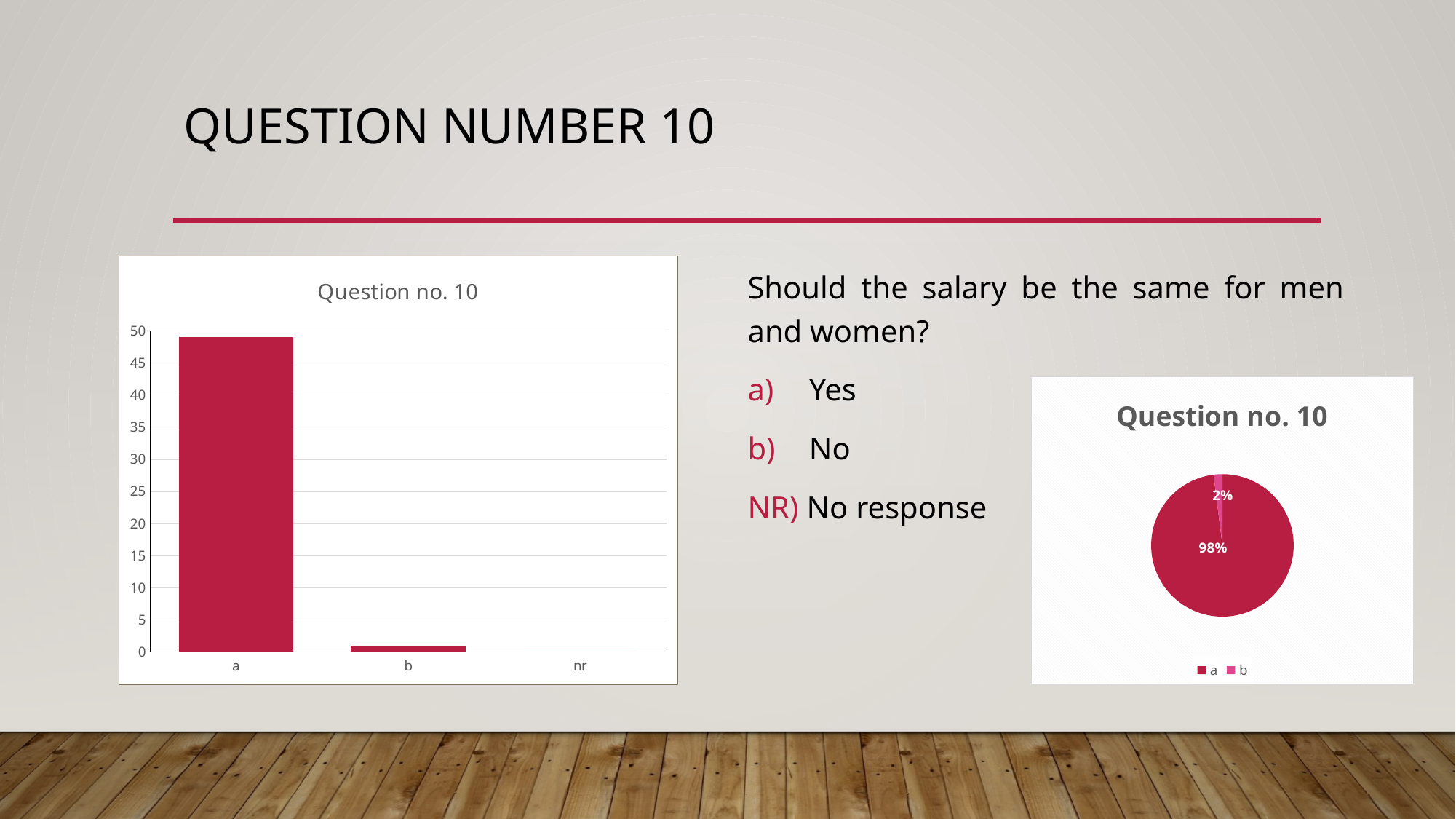
In the bar chart on the left, how many categories are shown on the x axis? 3 In the pie chart on the right, which slice is the largest? a In the bar chart on the left, is the value for b greater or less than 5? less In the bar chart on the left, which category has the highest value? a In the bar chart on the left, which is larger, the value for a or the value for b? a What kind of chart is the chart on the right of the slide? pie chart What is the title of the pie chart on the right? Question no. 10 In the pie chart on the right, how many entries does the legend list? 2 What kind of chart is the chart on the left of the slide? bar chart In the pie chart on the right, what share does slice a have? 98% In the bar chart on the left, is the value for a greater or less than 45? greater In the pie chart on the right, what share does slice b have? 2%